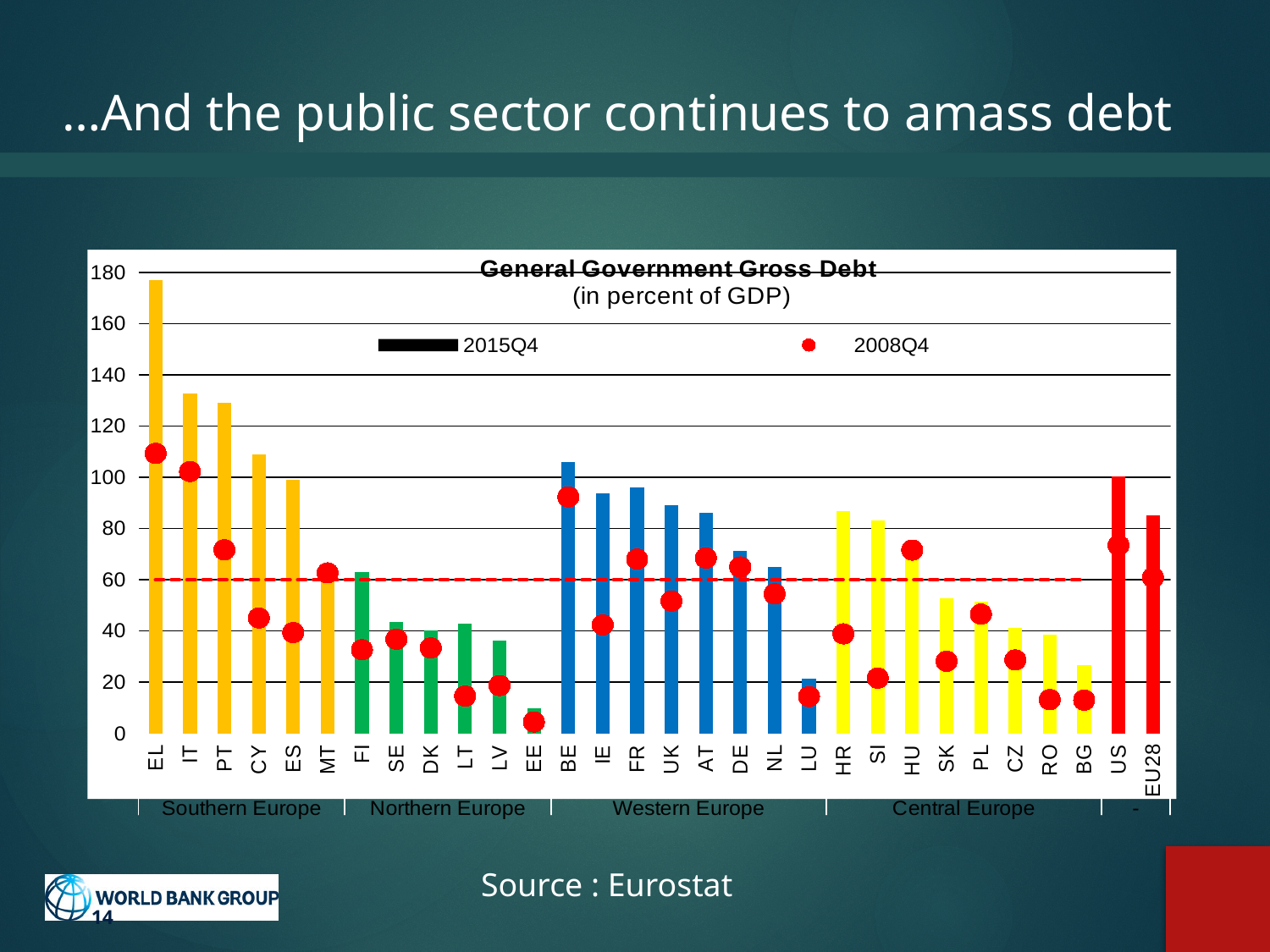
Which country has the highest 2015Q4 general government gross debt bar? EL Is the 2008Q4 value for EL greater or less than 100? greater Is the 2015Q4 value for EE greater or less than 20? less How many countries/categories are shown on the x axis? 30 Is the 2015Q4 value for LU greater or less than 40? less How many series does the legend list? 2 What is the title of the chart? General Government Gross Debt (in percent of GDP) What kind of chart is shown on the slide? bar chart Which country has the lowest 2015Q4 general government gross debt bar? EE Which has the larger 2015Q4 bar, BE or IE? BE